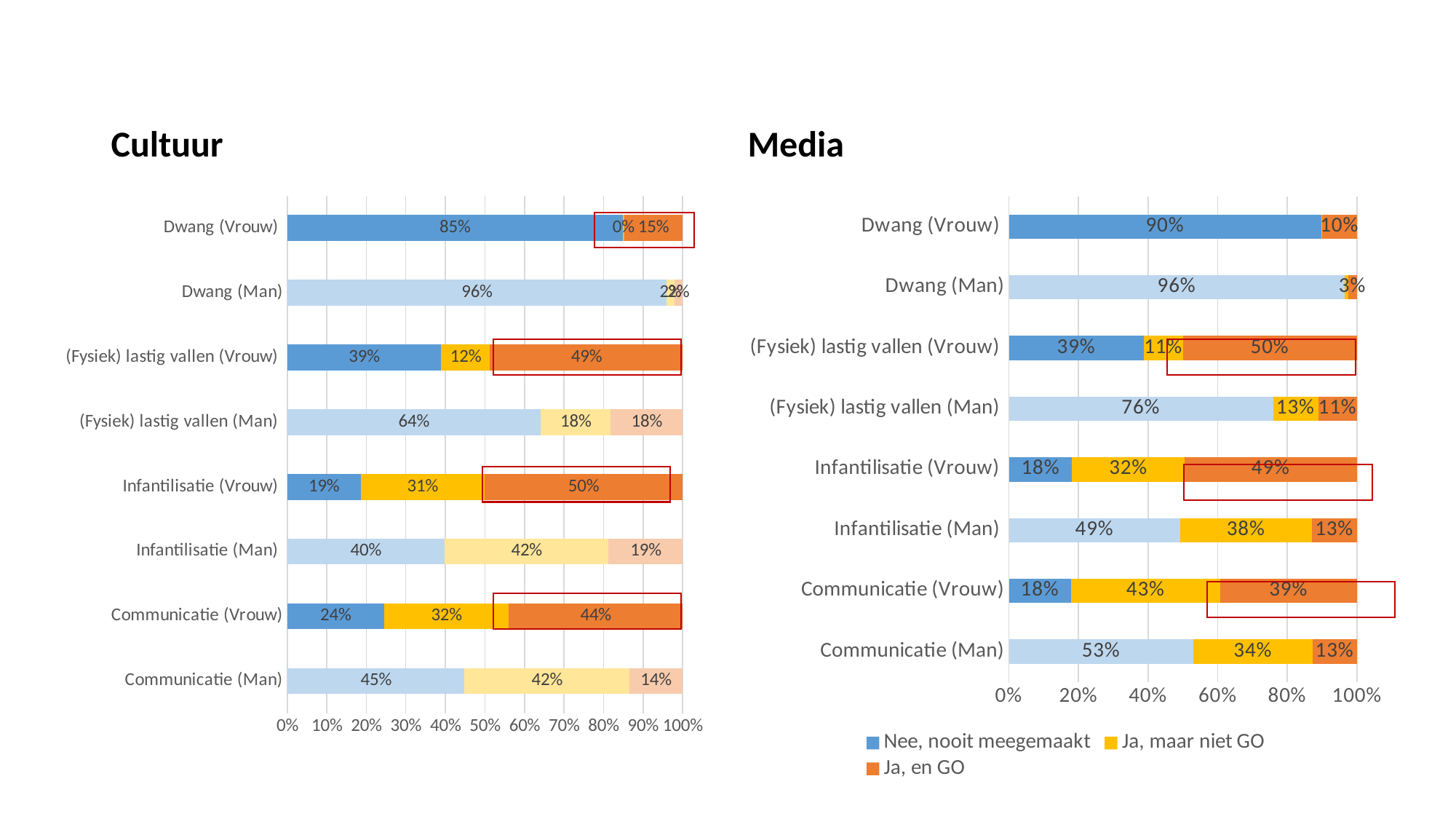
In the Cultuur chart, which category has the lowest 'Nee, nooit meegemaakt' value? Infantilisatie (Vrouw) In the Cultuur chart, what is the difference between the 'Ja, en GO' values for Infantilisatie (Vrouw) and Infantilisatie (Man)? 31% What is the title of the chart on the right side of the slide? Media In the Cultuur chart, what is the 'Nee, nooit meegemaakt' value for Dwang (Vrouw)? 85% What kind of chart is the Cultuur chart? Stacked bar chart In the Media chart, which is larger: the 'Ja, maar niet GO' value for Communicatie (Vrouw) or for Communicatie (Man)? Communicatie (Vrouw) In the Media chart, which category has the highest 'Nee, nooit meegemaakt' value? Dwang (Man) In the Media chart, what is the 'Nee, nooit meegemaakt' value for Communicatie (Man)? 53% How many categories are shown in the Media chart? 8 How many series does the legend of the Media chart list? 3 In the Media chart, what is the 'Ja, en GO' value for (Fysiek) lastig vallen (Vrouw)? 50% In the Cultuur chart, what is the 'Ja, maar niet GO' value for Infantilisatie (Man)? 42%